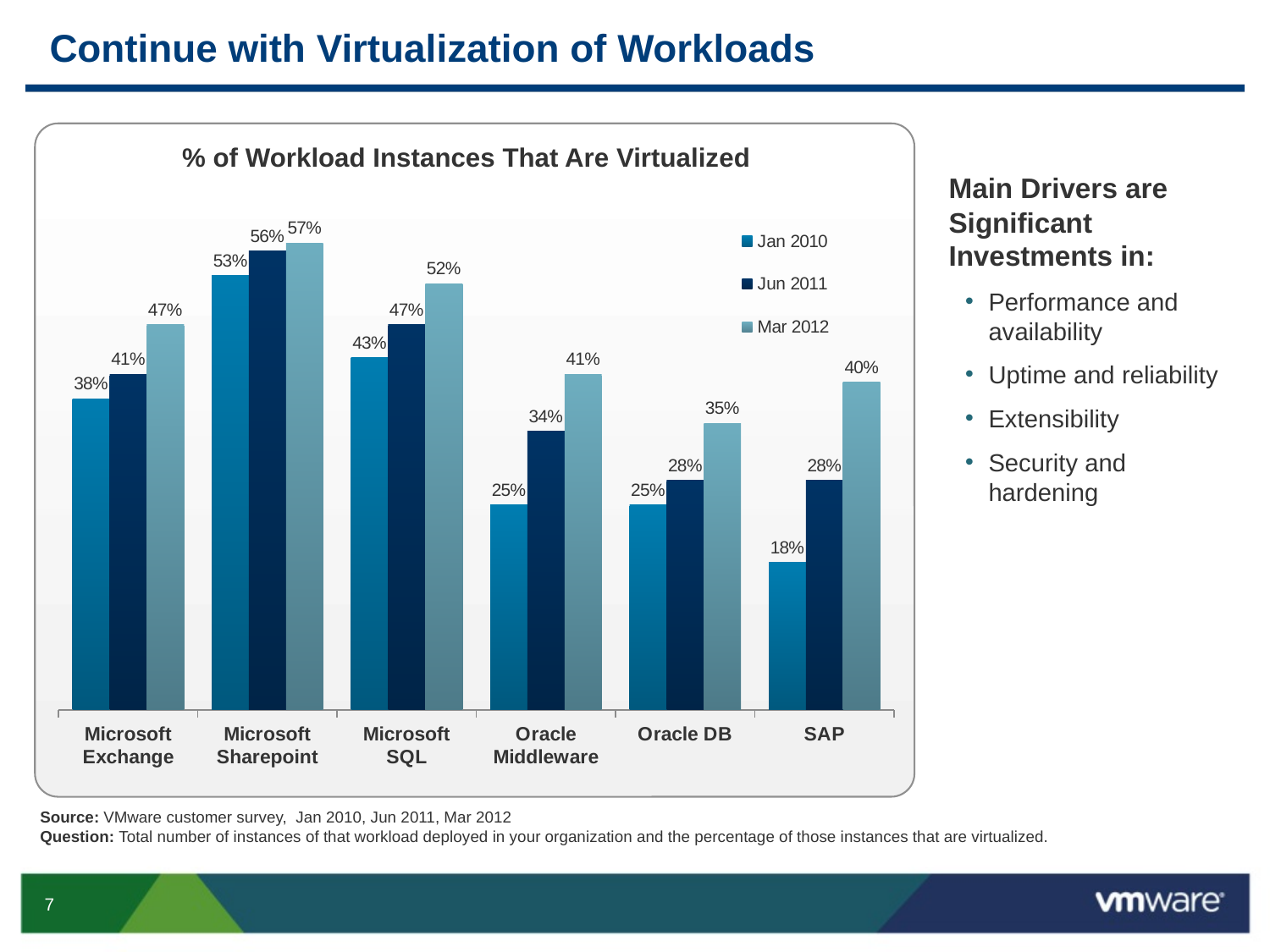
What is the difference between the Mar 2012 and Jan 2010 values for SAP? 22% How many series does the legend list? 3 For Microsoft SQL, do the values rise or fall from Jan 2010 to Mar 2012? Rise What kind of chart is shown? Bar chart What is the Mar 2012 value for Microsoft Sharepoint? 57% Which workload has the highest Mar 2012 value? Microsoft Sharepoint What is the Jun 2011 value for Oracle Middleware? 34% Which workload has the lowest Jan 2010 value? SAP How many workload categories are shown on the x axis? 6 What is the Jan 2010 value for SAP? 18% Which is larger: the Jun 2011 value for Oracle DB or the Jun 2011 value for Oracle Middleware? Oracle Middleware What is the title of the chart? % of Workload Instances That Are Virtualized